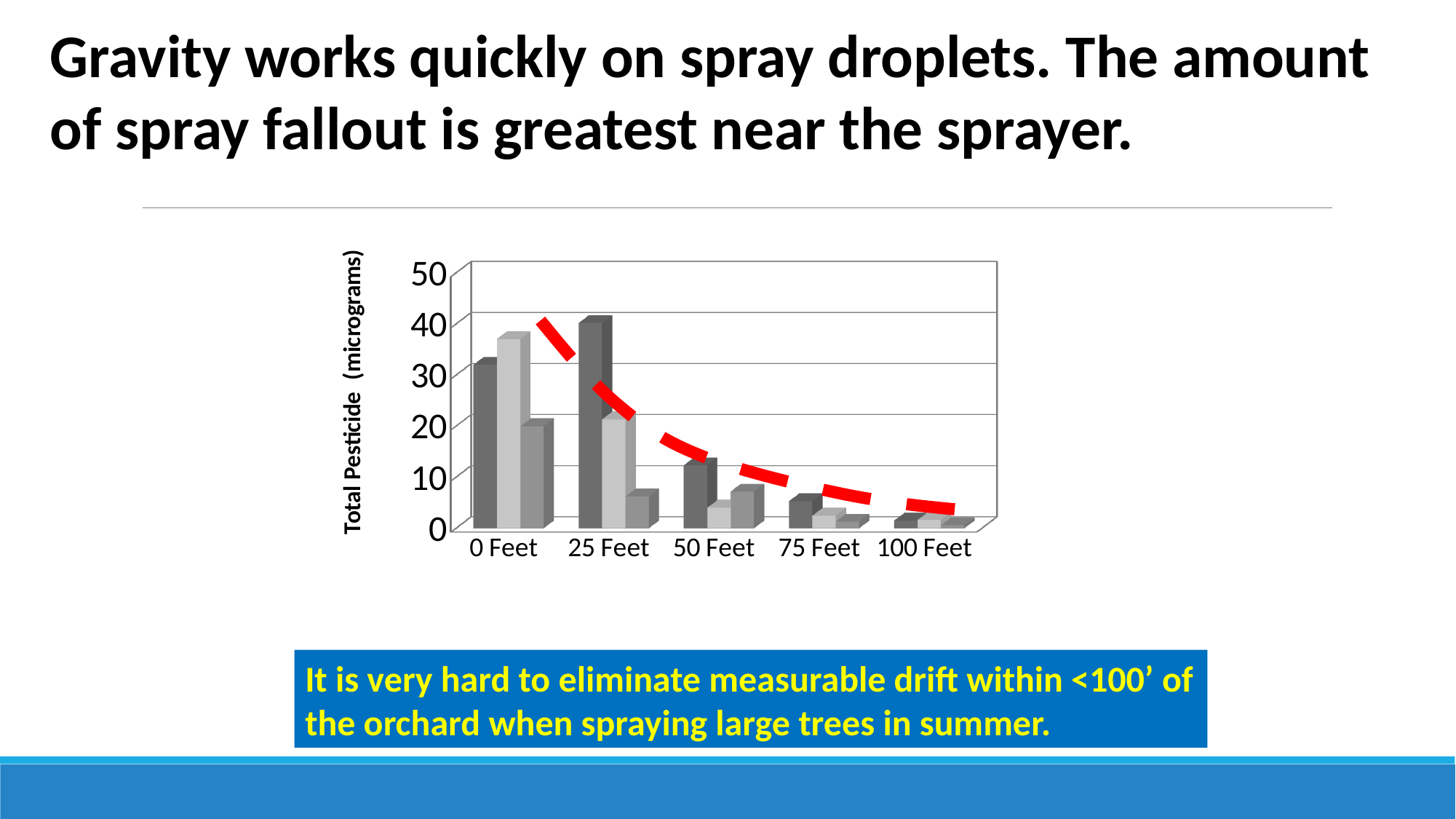
Is the value of the dark gray bar at 25 Feet greater or less than 30? greater How many bars are plotted for each distance category in the chart? 3 Which is larger: the dark gray bar at 0 Feet or the dark gray bar at 25 Feet? 25 Feet Are the values of all three bars at 100 Feet greater or less than 10? less Is the value of the light gray bar at 0 Feet greater or less than 30? greater Which distance category has the lowest bars in the chart? 100 Feet Which is larger: the light gray bar at 0 Feet or the light gray bar at 25 Feet? 0 Feet How many distance categories are shown on the x axis of the chart? 5 What is the title of the vertical axis of the chart? Total Pesticide (micrograms) What kind of chart is shown on the slide? Bar chart Do the bar heights generally rise or fall as distance increases from 0 Feet to 100 Feet? Fall